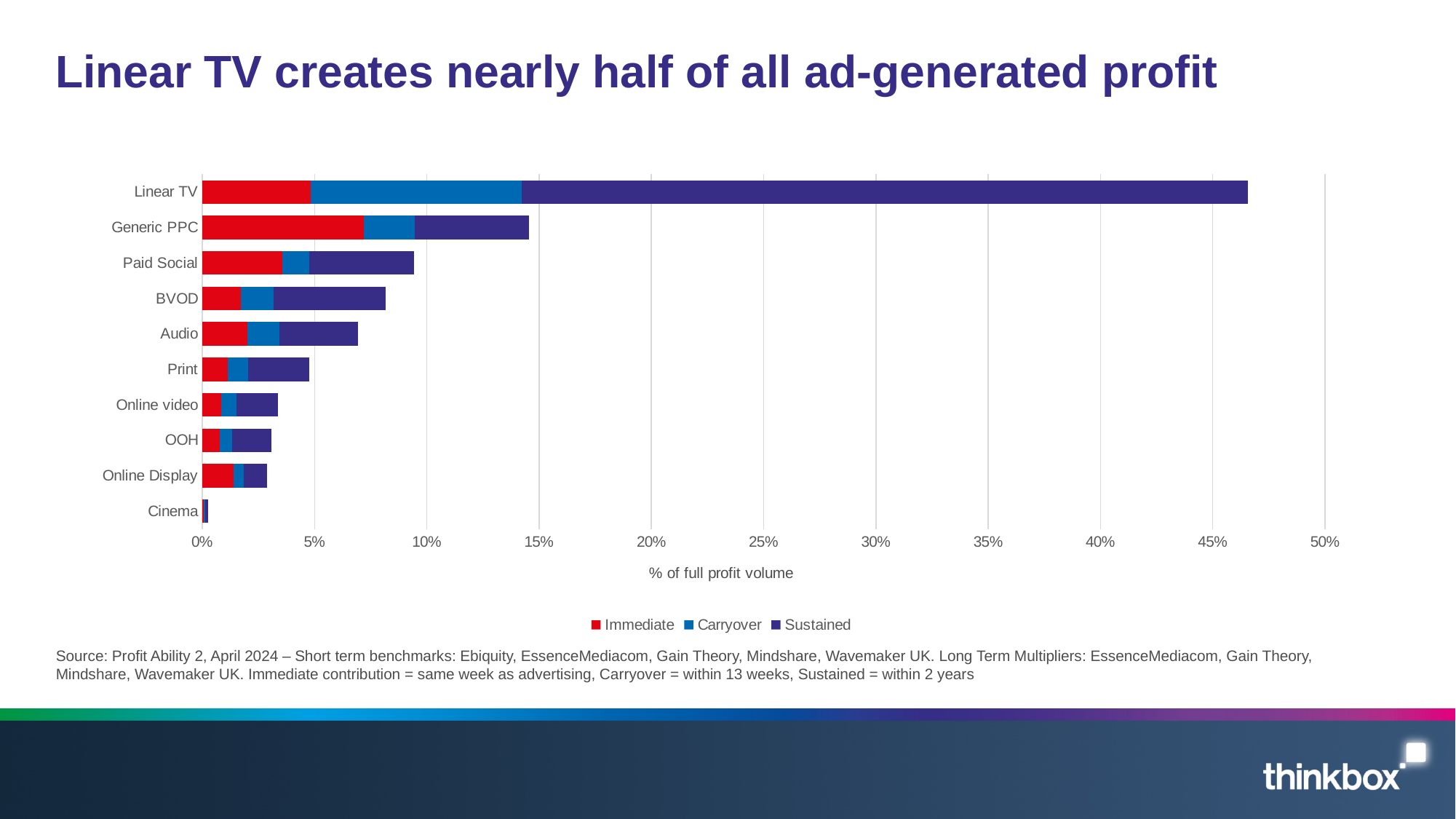
Which series is shown in red in the legend? Immediate Which has a larger total bar, Audio or Print? Audio Is the total value for Online video greater or less than 5%? less Is the total value for Generic PPC greater or less than 10%? greater Is the total value for Linear TV greater or less than 45%? greater Which channel has the lowest total share of full profit volume? Cinema What is the label on the horizontal axis of the chart? % of full profit volume How many series does the legend list? 3 Which channel has the highest total share of full profit volume? Linear TV What kind of chart is shown on the slide? Stacked bar chart Which has a larger total bar, Generic PPC or Paid Social? Generic PPC How many media channels (categories) are plotted on the chart? 10